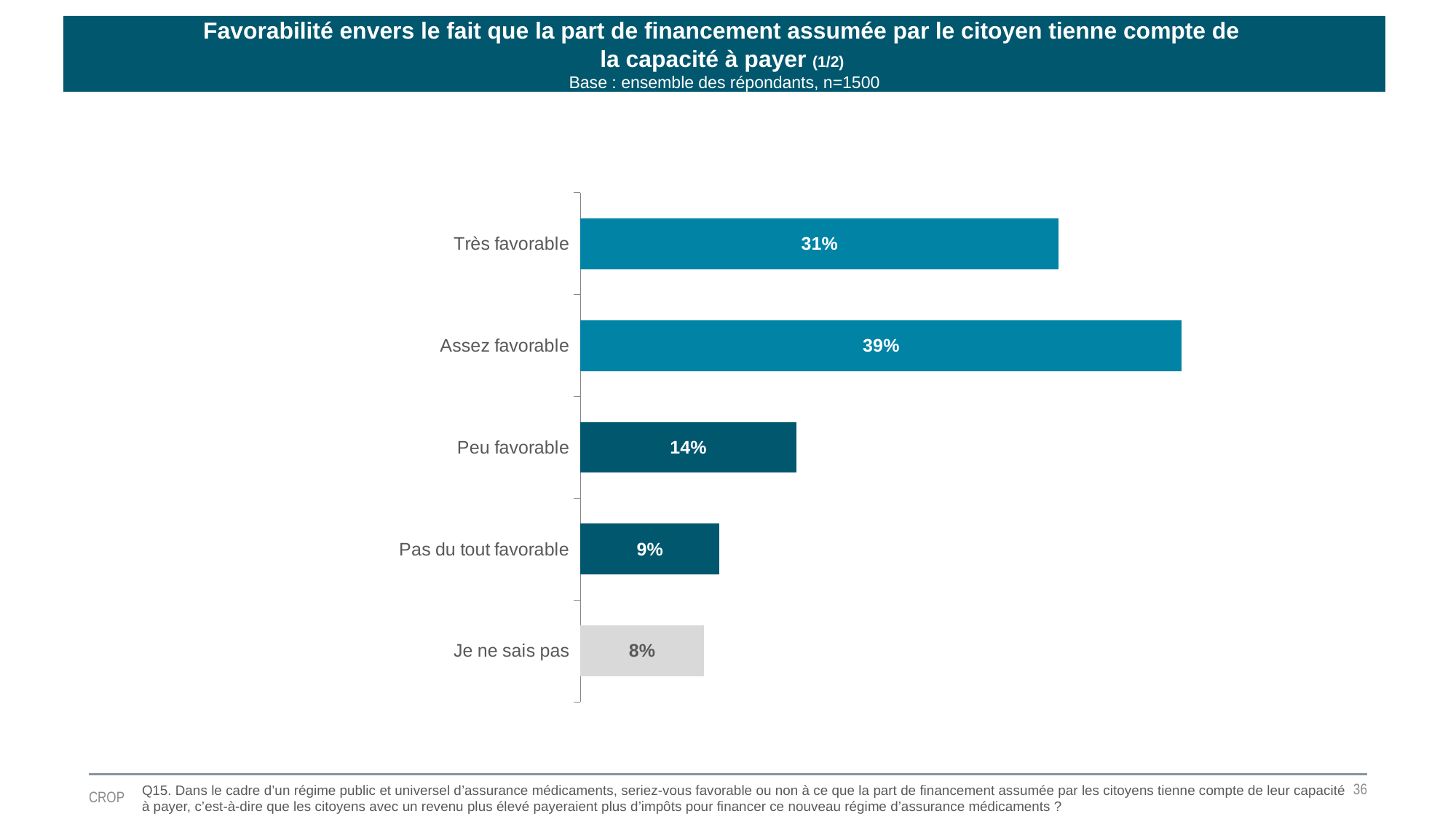
Which category has the lowest value? Je ne sais pas Which is larger, the value for "Peu favorable" or the value for "Pas du tout favorable"? Peu favorable What is the value for "Je ne sais pas"? 8% Which category has the highest value? Assez favorable What is the value for "Peu favorable"? 14% What is the value for "Assez favorable"? 39% How many categories are shown in the chart? 5 What kind of chart is shown on the slide? Bar chart What is the value for "Pas du tout favorable"? 9% What is the value for "Très favorable"? 31% What is the base (number of respondents) stated under the chart title? n=1500 What is the difference between the values for "Assez favorable" and "Très favorable"? 8%